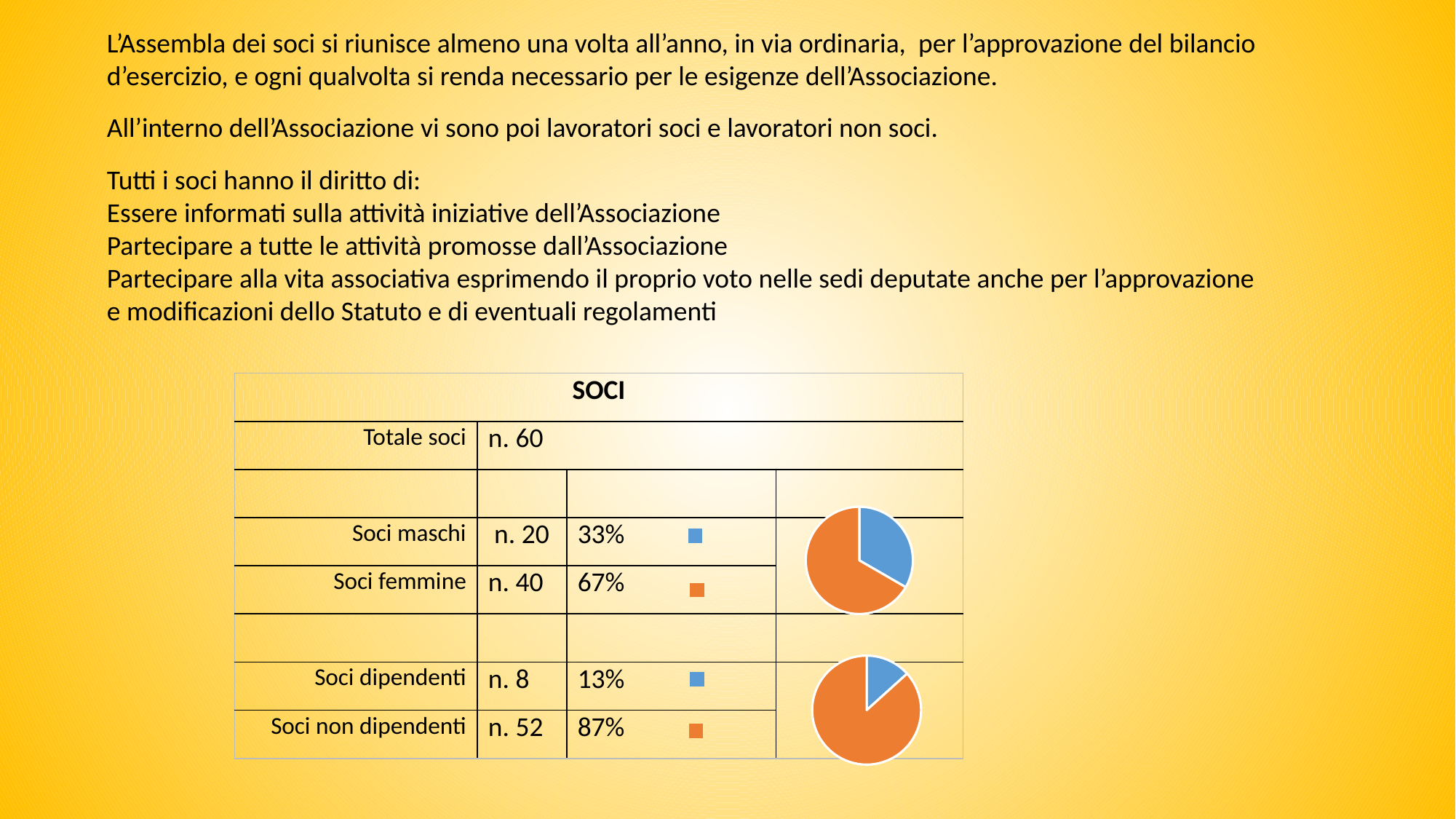
In the lower pie chart, what is the difference between Soci non dipendenti and Soci dipendenti? 44 In the lower pie chart, what is the value for Soci dipendenti? n. 8 In the upper pie chart, which category is the largest, Soci maschi or Soci femmine? Soci femmine In the lower pie chart, which category is the smallest? Soci dipendenti In the upper pie chart (Soci maschi / Soci femmine), what share of the pie is Soci maschi? 33% In the upper pie chart, what is the value for Soci maschi? n. 20 In the lower pie chart (Soci dipendenti / Soci non dipendenti), what share of the pie is Soci non dipendenti? 87% In the upper pie chart, which colour represents Soci maschi? blue In the upper pie chart (Soci maschi / Soci femmine), what share of the pie is Soci femmine? 67% What kind of chart is shown next to the Soci maschi and Soci femmine rows? pie chart How many slices does the lower pie chart (Soci dipendenti / Soci non dipendenti) have? 2 In the upper pie chart, what is the difference between Soci femmine and Soci maschi? 20